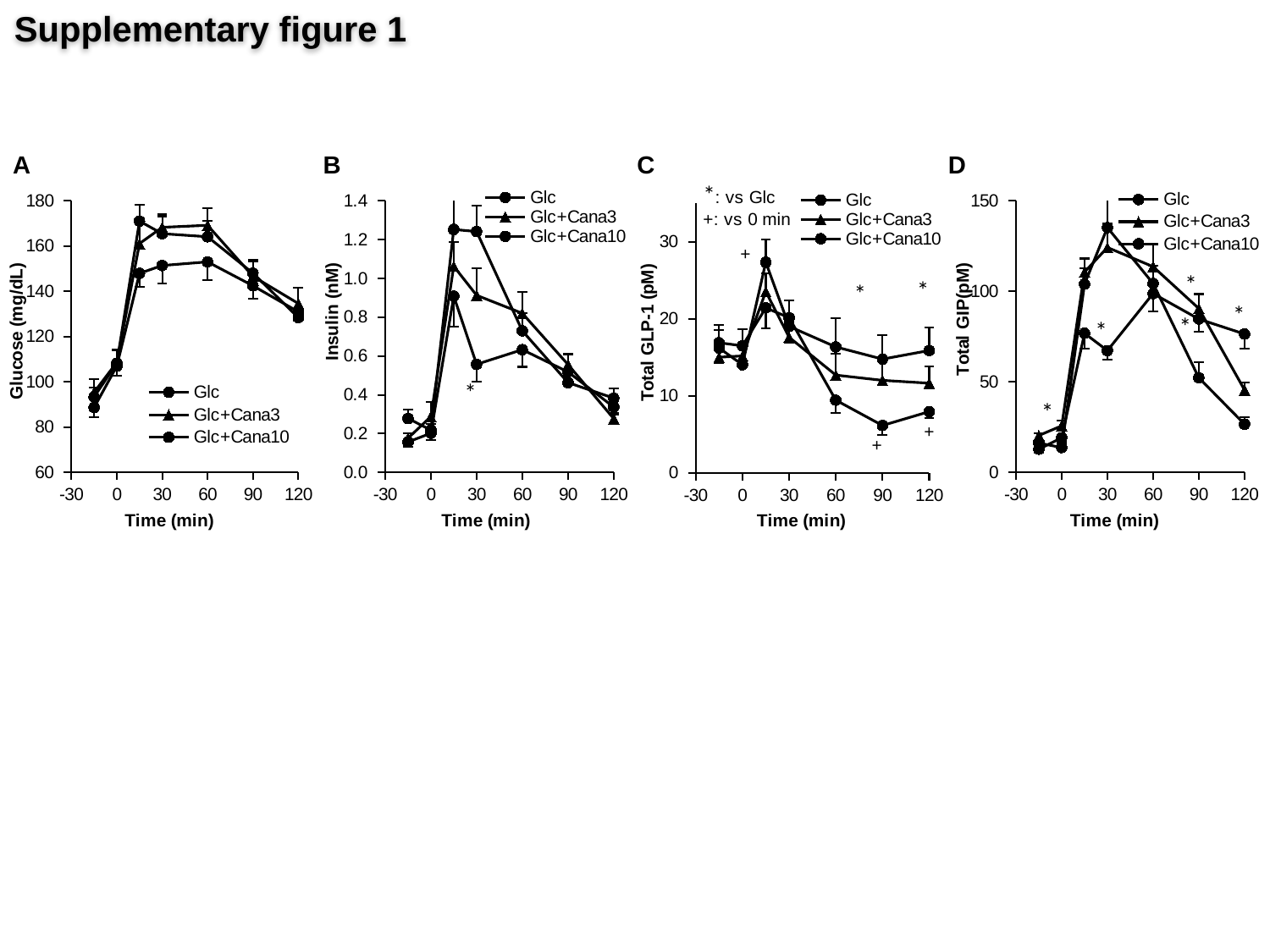
In chart A (Glucose), is the highest value at 15 min greater or less than 160 mg/dL? greater How many time points are plotted for each series in chart A (Glucose)? 7 How many series does the legend of chart B (Insulin) list? 3 What is the y-axis label of chart C? Total GLP-1 (pM) In chart D (Total GIP), are the values at -15 min greater or less than 50 pM? less What kind of chart is chart A (Glucose)? line chart In chart B (Insulin), is the Glc+Cana3 value at 15 min greater or less than 0.8 nM? greater In chart A (Glucose), do the values rise or fall between 60 min and 120 min? fall